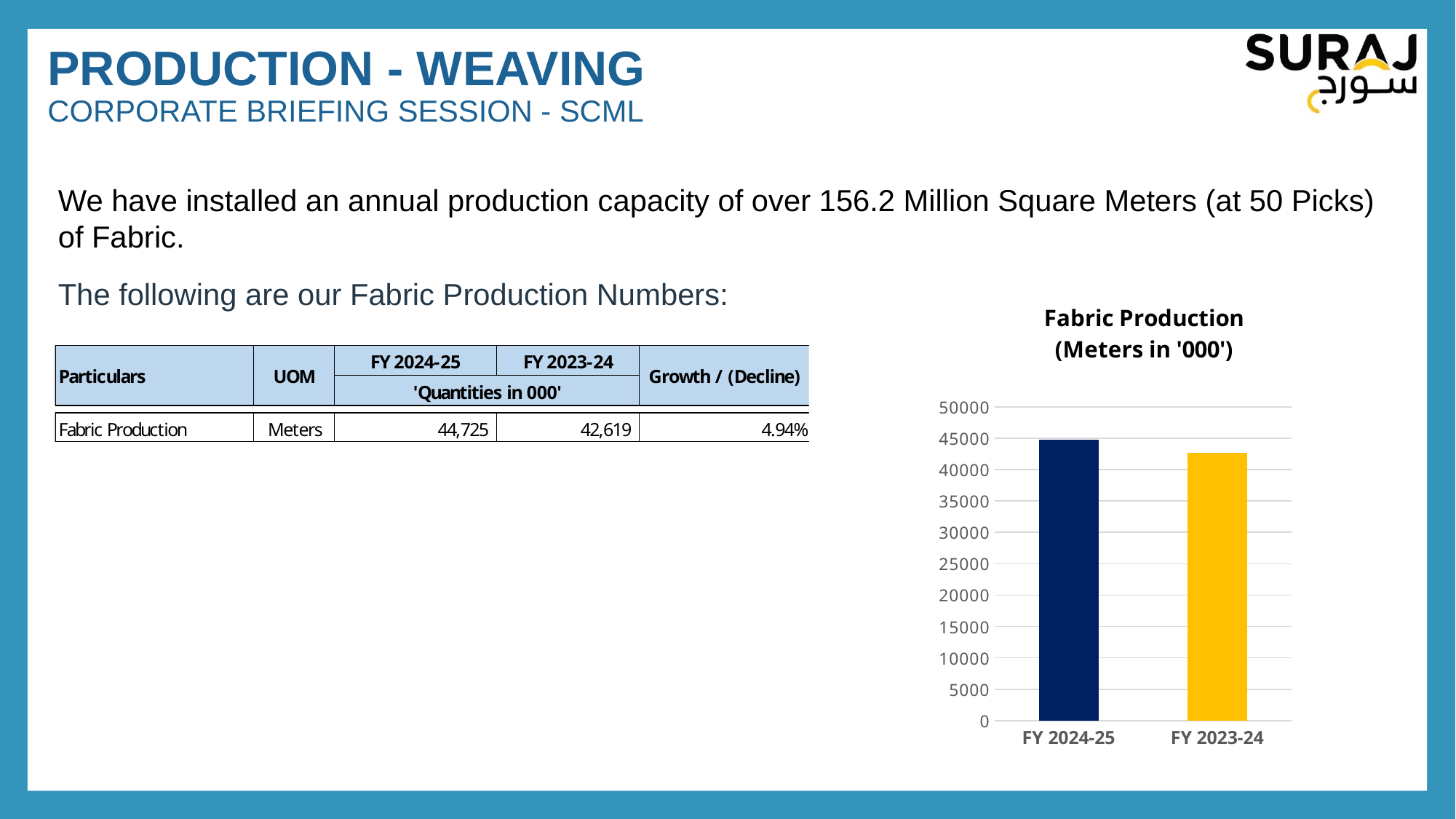
How many bars does the chart show? 2 Which fiscal year has the higher fabric production in the chart? FY 2024-25 Is the value for FY 2024-25 greater or less than 45000? less Is the bar for FY 2024-25 taller or shorter than the bar for FY 2023-24? taller Which fiscal year has the lower fabric production in the chart? FY 2023-24 What is the fabric production value for FY 2023-24 (in '000 meters), as printed in the table? 42,619 What is the title of the chart? Fabric Production (Meters in '000') Is the value for FY 2023-24 greater or less than 45000? less What colour is the bar for FY 2023-24? yellow What kind of chart is shown on the slide? bar chart Is the value for FY 2024-25 greater or less than 40000? greater What is the fabric production value for FY 2024-25 (in '000 meters), as printed in the table? 44,725